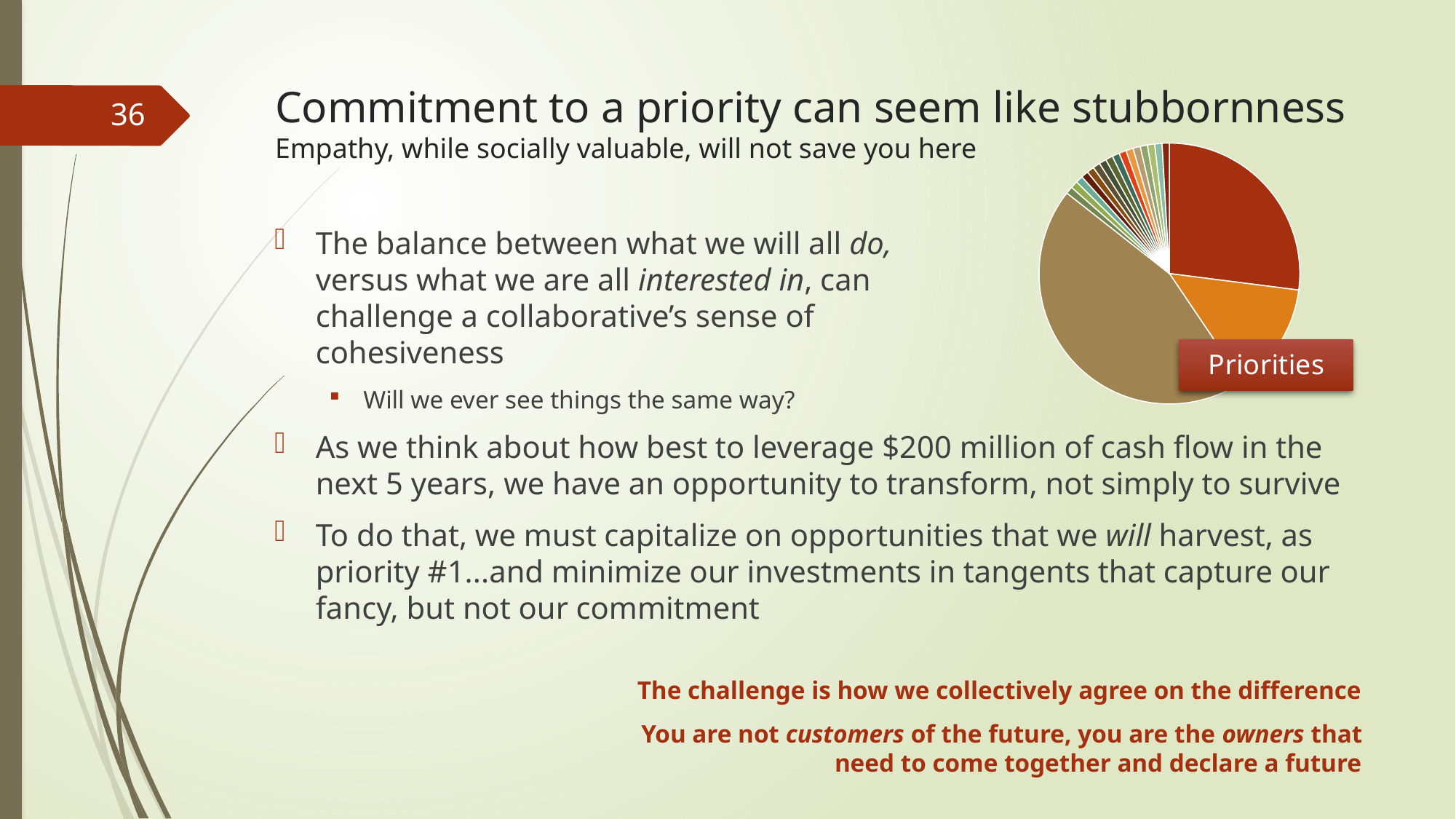
In the pie chart, which is larger, the tan slice or the dark red slice? the tan slice In the pie chart, which is larger, the dark red slice or the orange slice? the dark red slice Does the largest slice of the pie chart take up more or less than half of the pie? less What label is shown on the pie chart? Priorities What kind of chart is shown on the slide? pie chart What colour is the largest slice of the pie chart? tan/brown